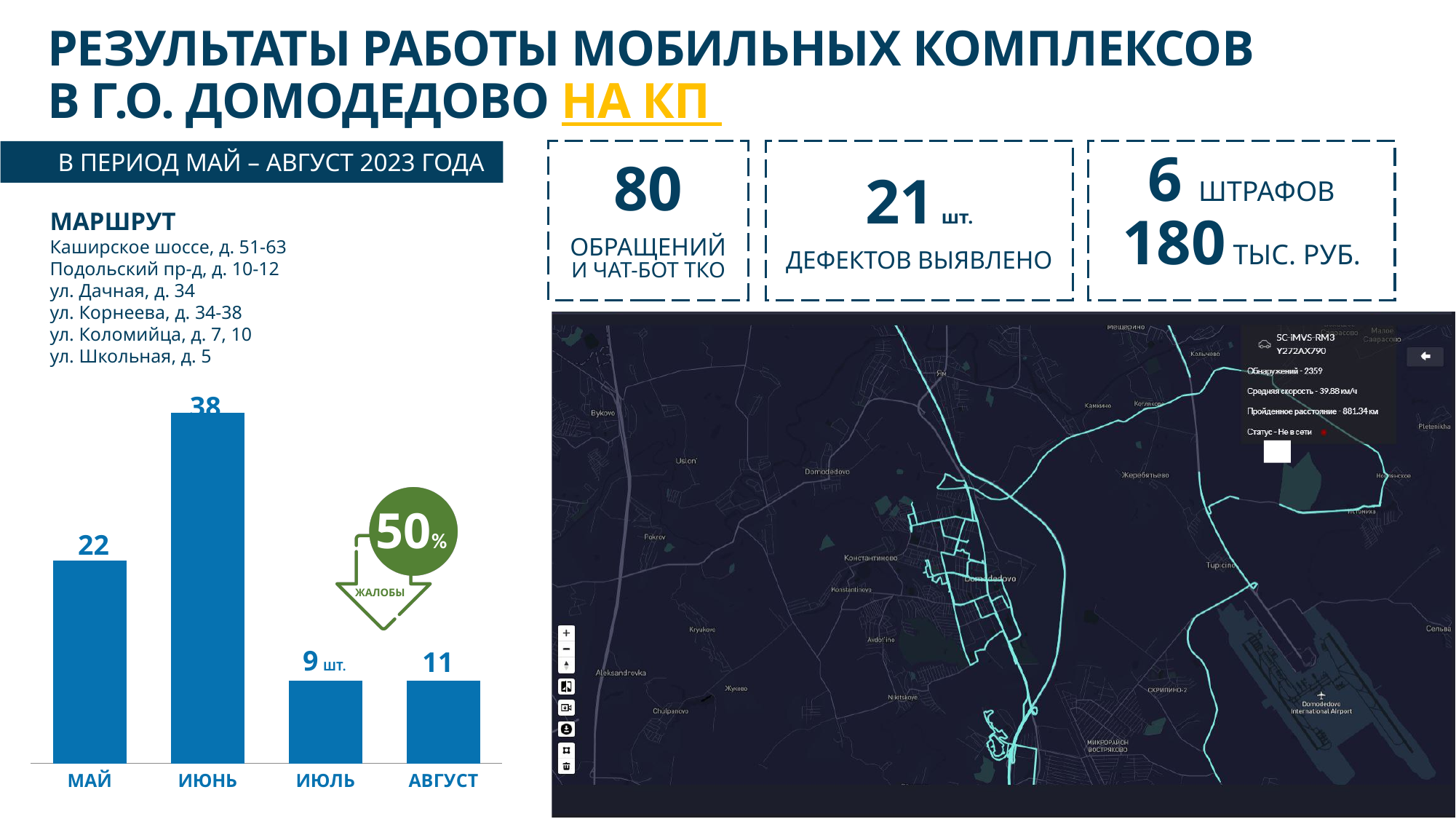
What is the value for МАЙ in the bar chart? 22 Which month has the lowest value in the bar chart? ИЮЛЬ Which is larger in the bar chart, the value for МАЙ or the value for АВГУСТ? МАЙ What kind of chart is shown on the left of the slide? bar chart What percentage is shown in the green circle next to the bar chart? 50% What is the difference between the values for АВГУСТ and ИЮЛЬ in the bar chart? 2 How many months are shown in the bar chart? 4 What is the value for АВГУСТ in the bar chart? 11 Which month has the highest value in the bar chart? ИЮНЬ What is the value for ИЮЛЬ in the bar chart? 9 шт. What is the value for ИЮНЬ in the bar chart? 38 What is the difference between the values for ИЮНЬ and МАЙ in the bar chart? 16